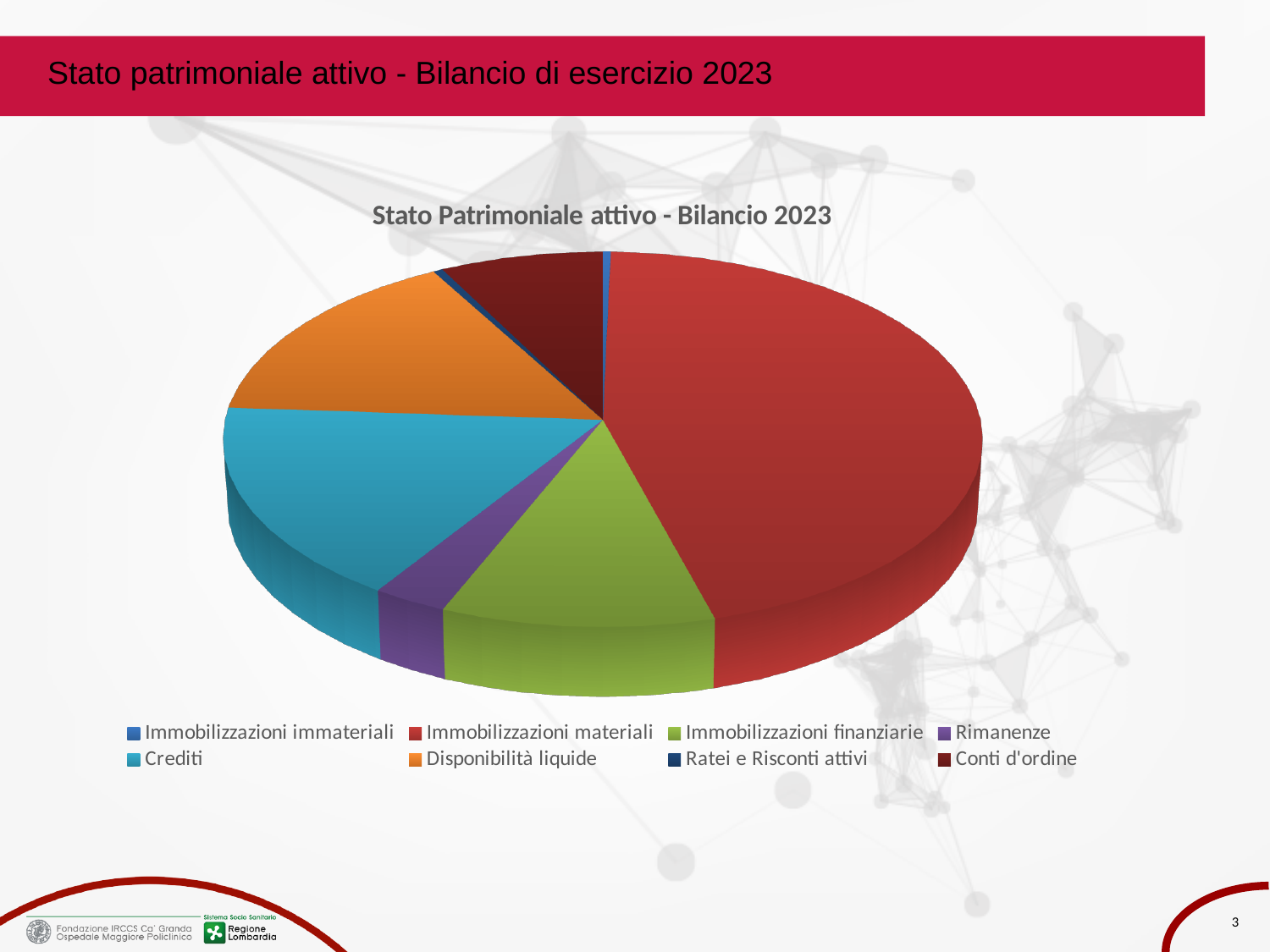
Which slice is larger, Immobilizzazioni finanziarie or Rimanenze? Immobilizzazioni finanziarie Which slice is larger, Disponibilità liquide or Immobilizzazioni immateriali? Disponibilità liquide Which category is shown in orange in the pie chart? Disponibilità liquide What kind of chart is shown on the slide? Pie chart Which slice is larger, Immobilizzazioni materiali or Crediti? Immobilizzazioni materiali What is the title of the chart? Stato Patrimoniale attivo - Bilancio 2023 How many categories does the pie chart's legend list? 8 Which category has the largest slice of the pie chart? Immobilizzazioni materiali